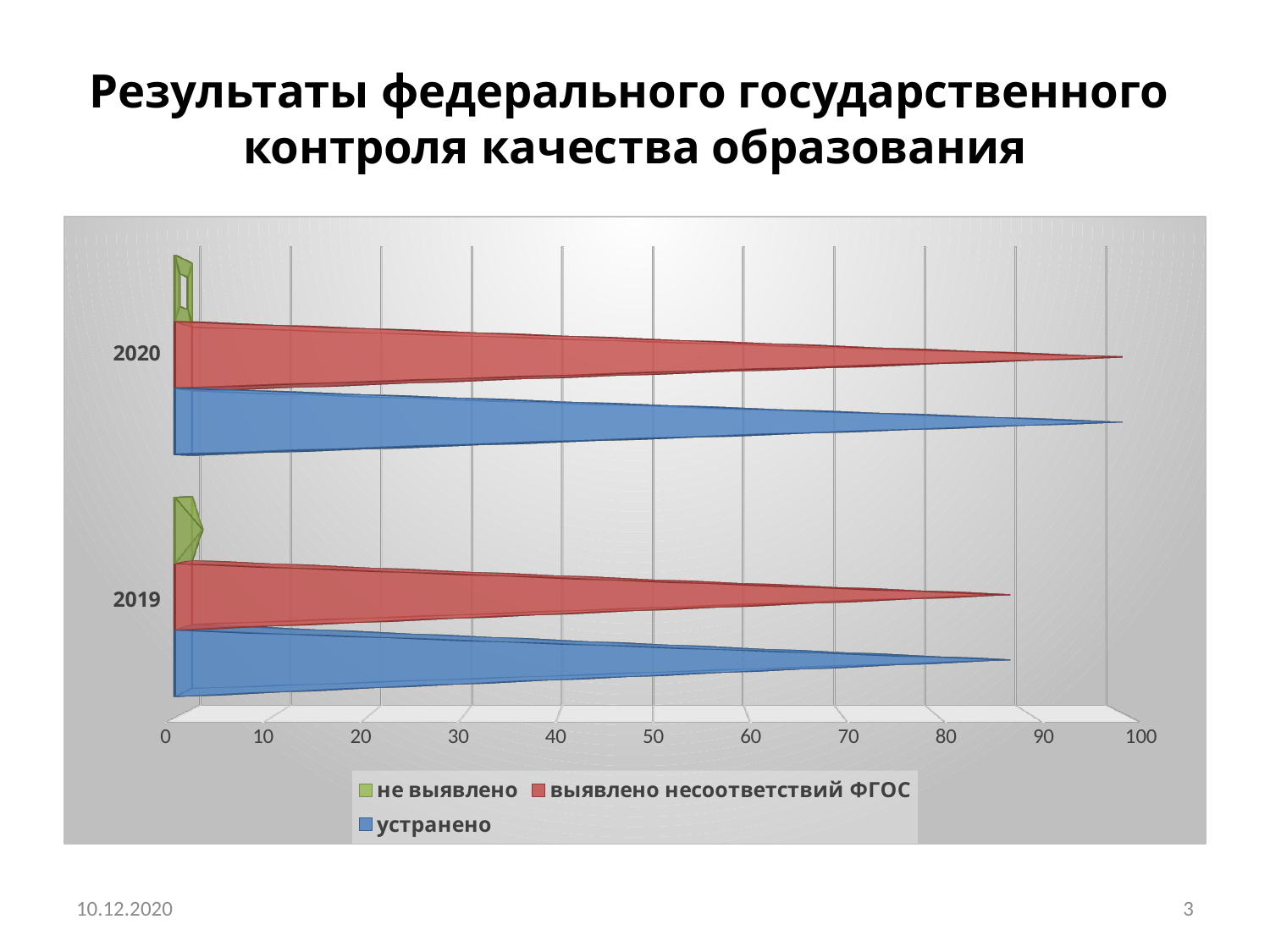
Is the value for "выявлено несоответствий ФГОС" in 2019 greater or less than 90? less Which year has the larger value for "выявлено несоответствий ФГОС", 2019 or 2020? 2020 Is the value for "устранено" in 2020 greater or less than 90? greater What kind of chart is shown on the slide? bar chart How many categories (years) are shown on the chart? 2 Which series is shown in green in the legend? не выявлено Is the value for "устранено" in 2019 greater or less than 80? greater How many series does the legend list? 3 What is the title of the slide containing the chart? Результаты федерального государственного контроля качества образования Which year has the larger value for "устранено", 2019 or 2020? 2020